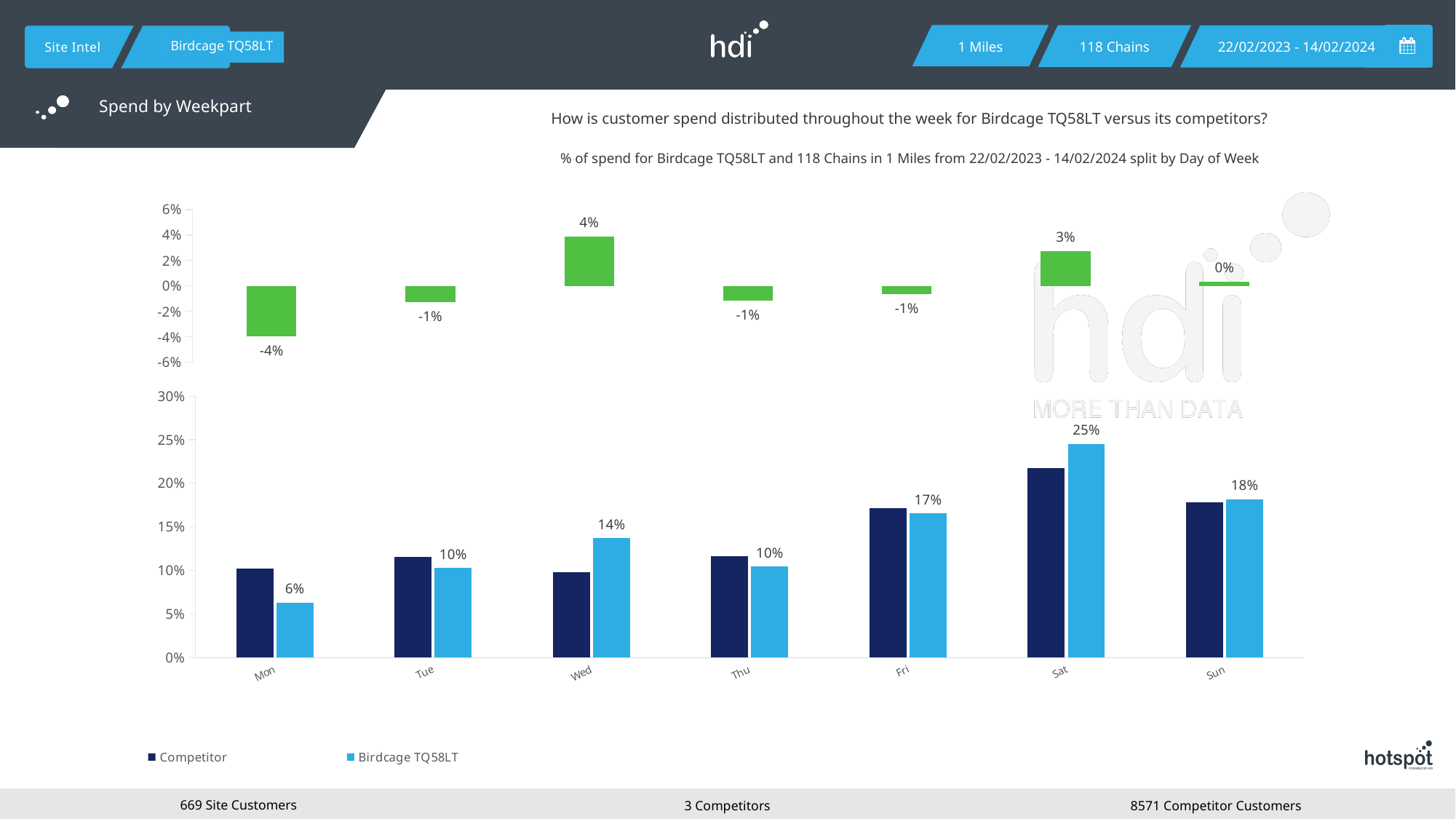
In the top chart, what is the value for Wed? 4% How many series does the legend of the bottom chart list? 2 In the bottom chart, what is the value for Birdcage TQ58LT on Sat? 25% In the bottom chart, is the Competitor value for Sat greater or less than 20%? greater In the top chart, which day has the lowest value? Mon In the bottom chart, what is the difference between the Birdcage TQ58LT values for Sat and Sun? 7% In the bottom chart, which is larger on Mon: the Competitor value or the Birdcage TQ58LT value? Competitor In the bottom chart, which day has the lowest Birdcage TQ58LT value? Mon In the bottom chart, which day has the highest Birdcage TQ58LT value? Sat How many days are shown on the x axis of the bottom chart? 7 In the bottom chart, what is the value for Birdcage TQ58LT on Mon? 6%